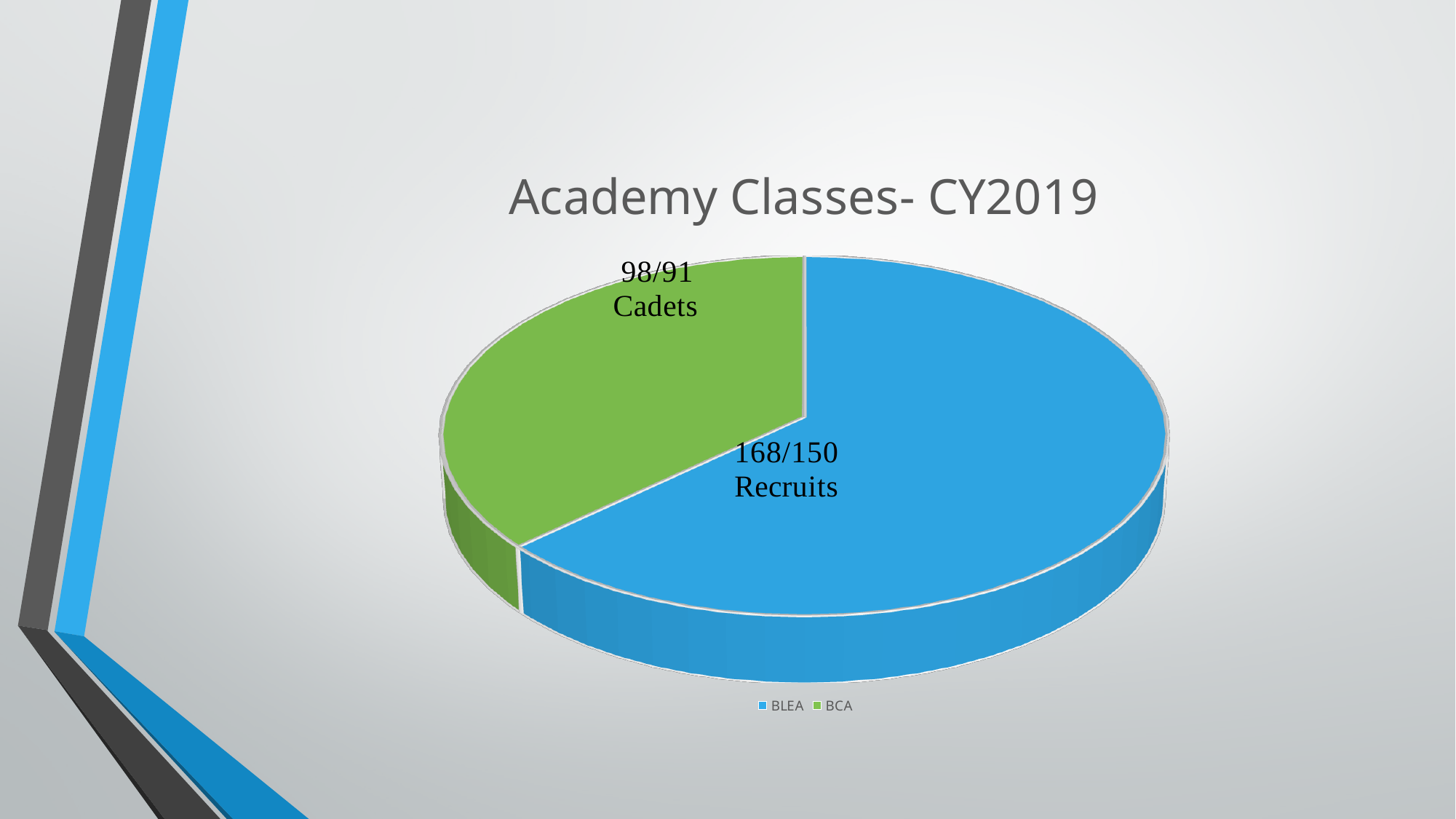
What label is printed on the BLEA slice? 168/150 Recruits Which slice is larger, BLEA or BCA? BLEA Which slice is the largest in the pie chart? BLEA Which slice is labelled with Recruits? BLEA Which slice is labelled with Cadets? BCA How many entries does the legend list? 2 Which slice is the smallest in the pie chart? BCA What kind of chart is shown on the slide? Pie chart How many slices does the pie chart have? 2 What is the title of the chart? Academy Classes- CY2019 What label is printed on the BCA slice? 98/91 Cadets What colour is the BCA slice? Green